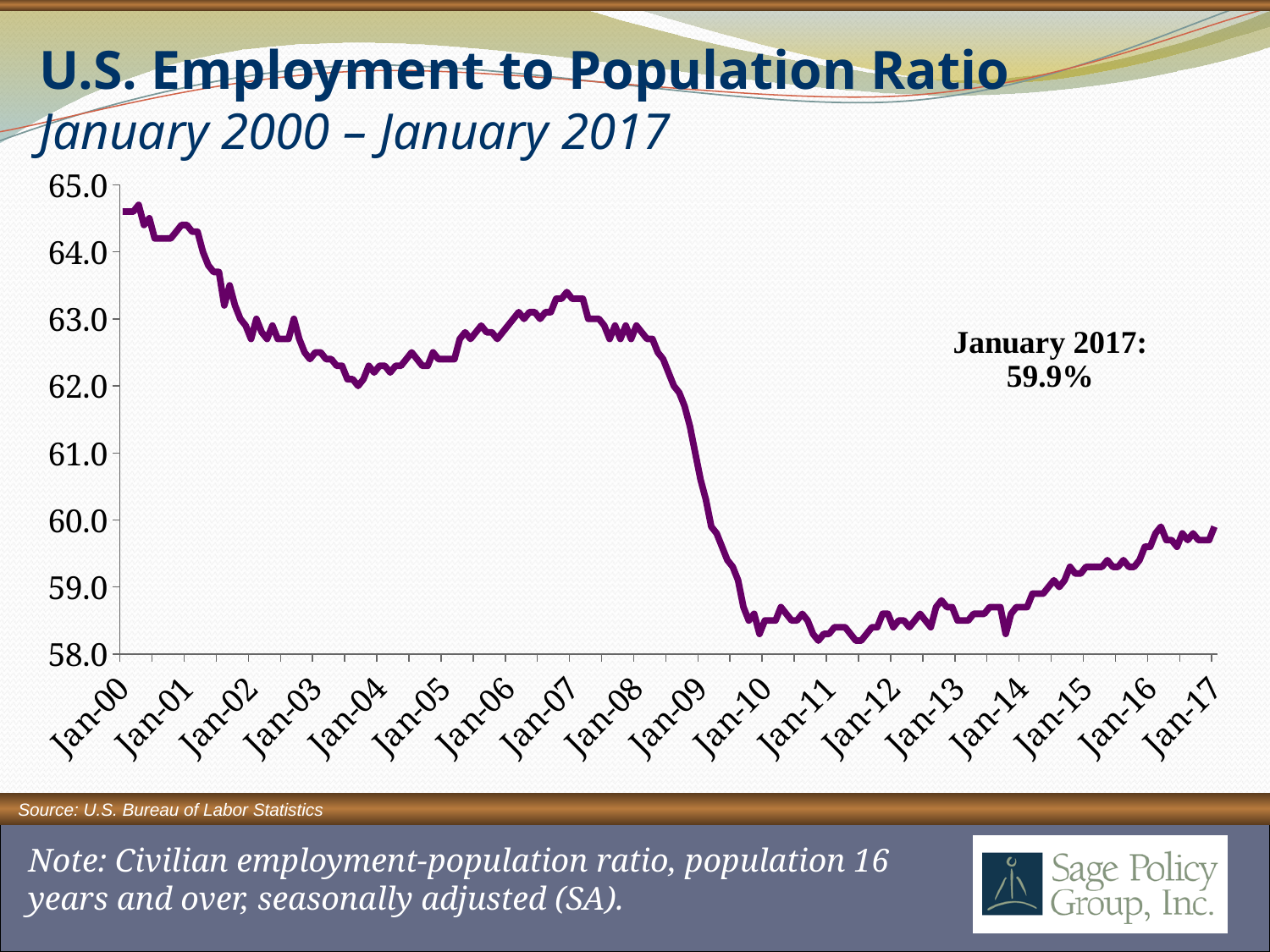
How many year labels are shown on the x axis? 18 What source is cited for the chart data? U.S. Bureau of Labor Statistics Does the line rise or fall between Jan-08 and Jan-10? Fall Is the value for Jan-04 greater or less than 63.0? less Which is larger, the value at Jan-00 or the value at Jan-17? Jan-00 What kind of chart is shown on the slide? Line chart Is the value for Jan-15 greater or less than 60.0? less Which is larger, the value at Jan-07 or the value at Jan-11? Jan-07 What is the employment to population ratio for January 2017 according to the label on the chart? 59.9% Is the value for Jan-10 greater or less than 59.0? less Does the line rise or fall between Jan-12 and Jan-17? Rise